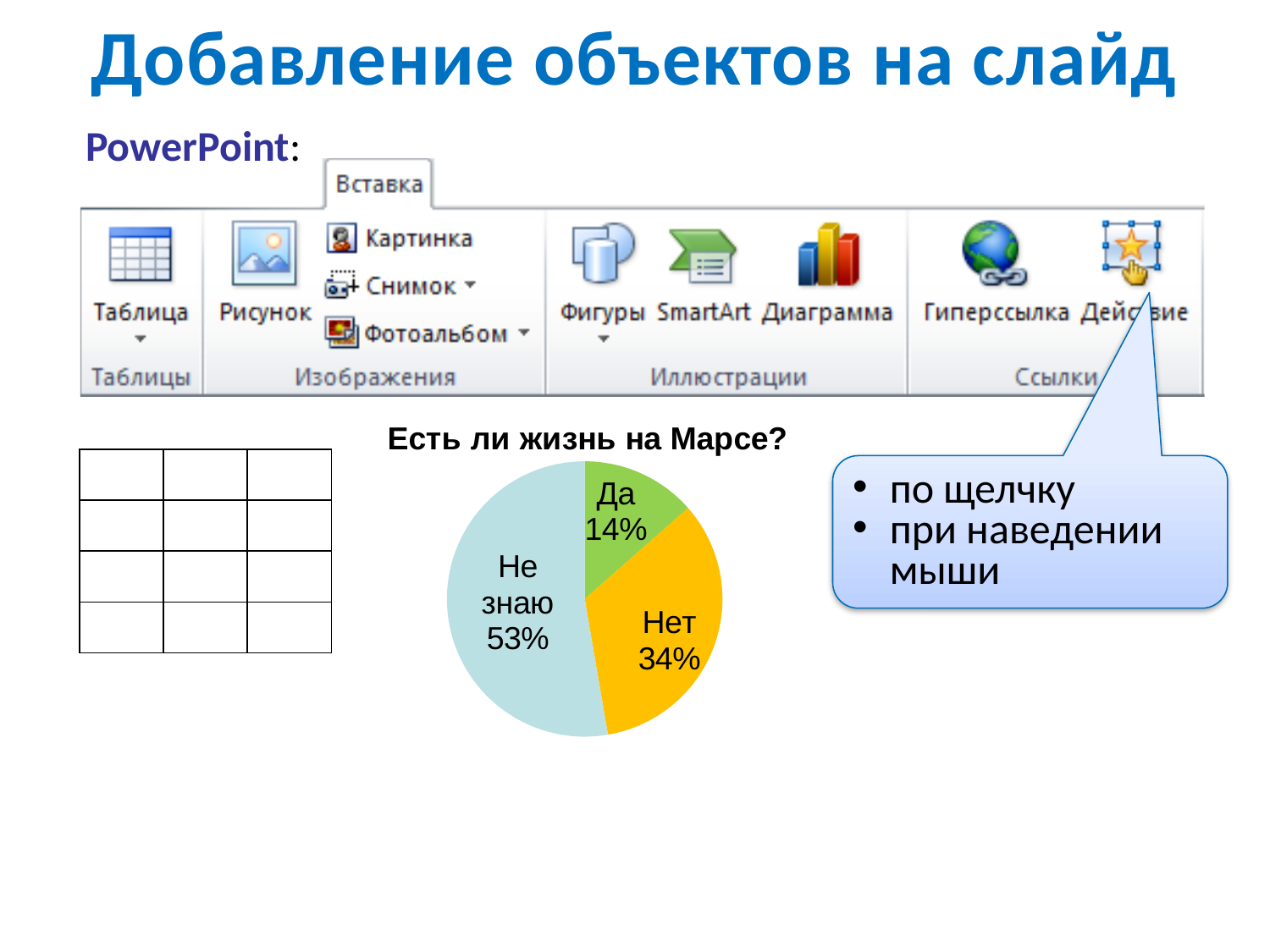
Which is larger, the "Нет" slice or the "Да" slice? Нет What is the title of the pie chart? Есть ли жизнь на Марсе? What share of the pie does "Нет" have? 34% What share of the pie does "Не знаю" have? 53% What is the difference between the "Не знаю" and "Нет" shares? 19% Which slice of the pie is the largest? Не знаю How many slices does the pie chart have? 3 What share of the pie does "Да" have? 14% What kind of chart is shown on the slide? pie chart Which slice of the pie is the smallest? Да What is the difference between the "Нет" and "Да" shares? 20% What colour is the "Нет" slice of the pie? yellow